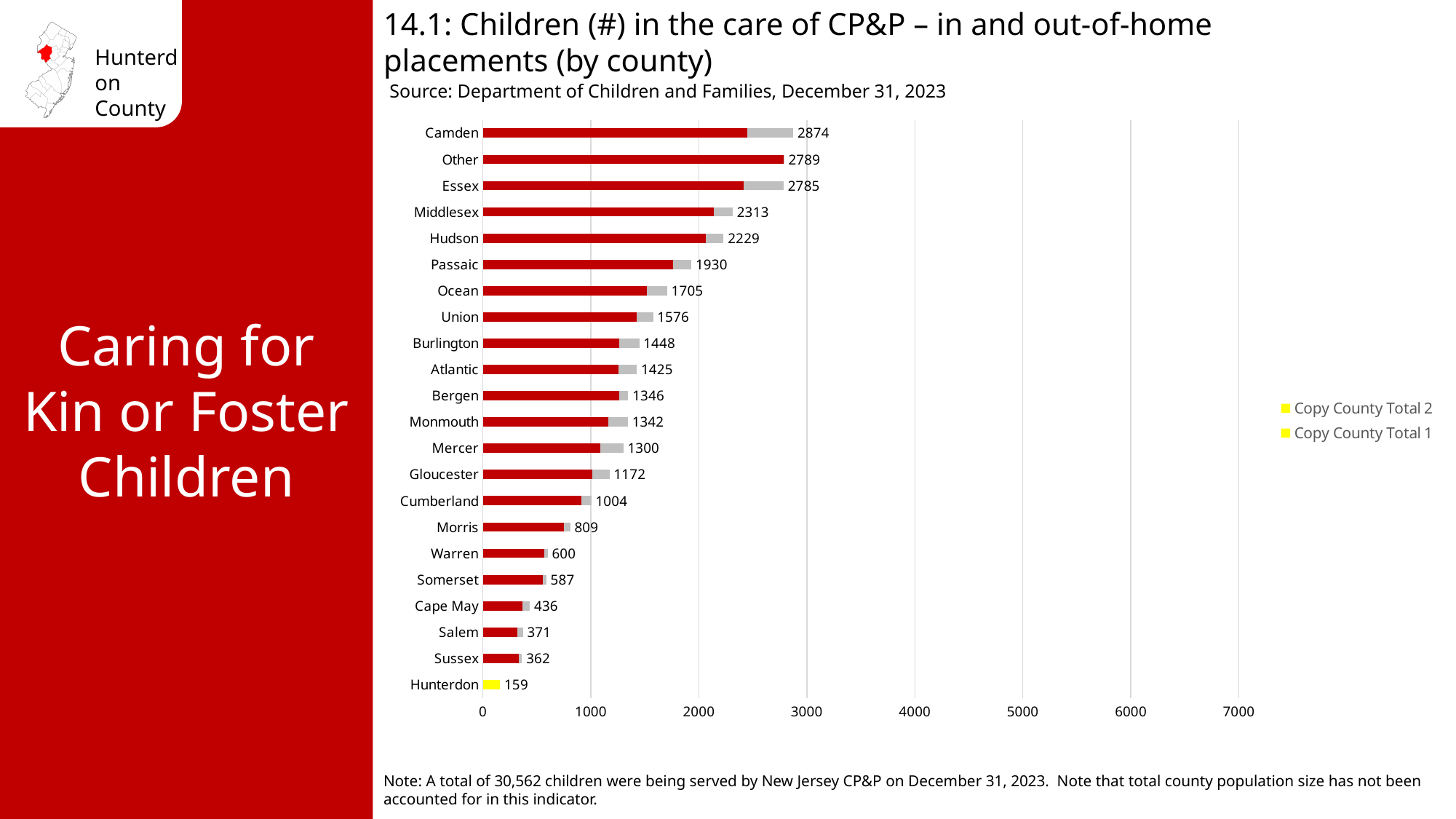
What is the difference between the totals for Warren and Somerset? 13 How many counties (categories) are shown on the chart? 22 What is the difference between the totals for Camden and Essex? 89 What is the total value shown for Passaic? 1930 What is the total number of children in the care of CP&P for Hunterdon? 159 Which county has the lowest total number of children in the care of CP&P? Hunterdon Which has a larger total, Ocean or Union? Ocean Which county has the highest total number of children in the care of CP&P? Camden What kind of chart is shown on the slide? Bar chart How many series does the legend list? 2 Is the total for Middlesex greater or less than 2000? greater What is the total number of children in the care of CP&P for Camden? 2874